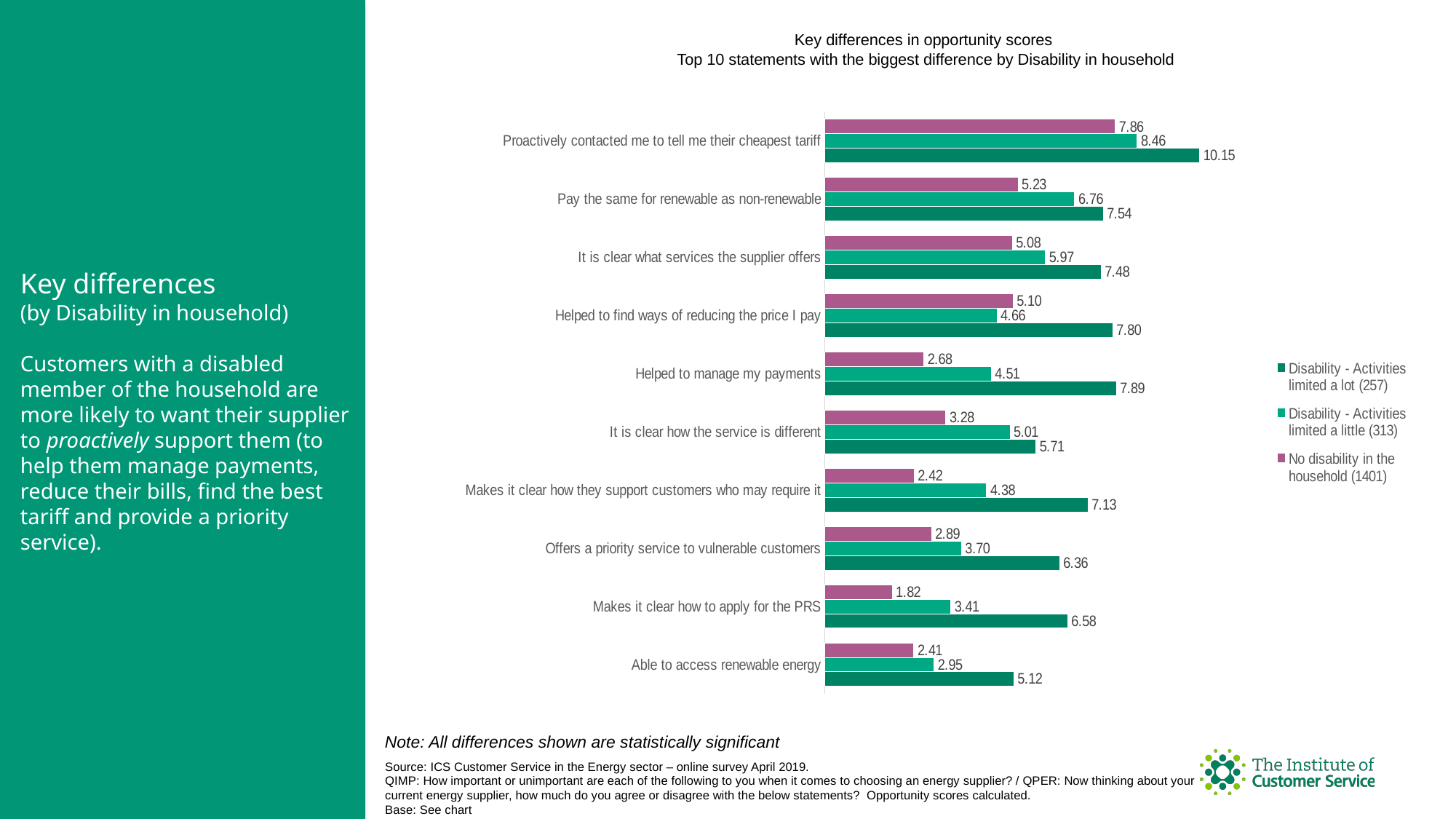
What is the difference between the 'Disability - Activities limited a little (313)' score and the 'No disability in the household (1401)' score for 'Able to access renewable energy'? 0.54 For 'Helped to find ways of reducing the price I pay', which is larger: the 'No disability in the household (1401)' score or the 'Disability - Activities limited a little (313)' score? No disability in the household (1401) How many statements are shown on the chart? 10 How many series does the legend list? 3 What kind of chart is shown on the slide? Bar chart Which statement has the highest score for the 'Disability - Activities limited a lot (257)' series? Proactively contacted me to tell me their cheapest tariff What is the opportunity score for 'Helped to manage my payments' for the 'No disability in the household (1401)' series? 2.68 What is the opportunity score for 'Makes it clear how to apply for the PRS' for the 'Disability - Activities limited a little (313)' series? 3.41 What is the difference between the 'Disability - Activities limited a lot (257)' score and the 'No disability in the household (1401)' score for 'Helped to manage my payments'? 5.21 What is the title of the chart? Key differences in opportunity scores Top 10 statements with the biggest difference by Disability in household What is the opportunity score for 'Proactively contacted me to tell me their cheapest tariff' for the 'Disability - Activities limited a lot (257)' series? 10.15 Which statement has the lowest score for the 'No disability in the household (1401)' series? Makes it clear how to apply for the PRS